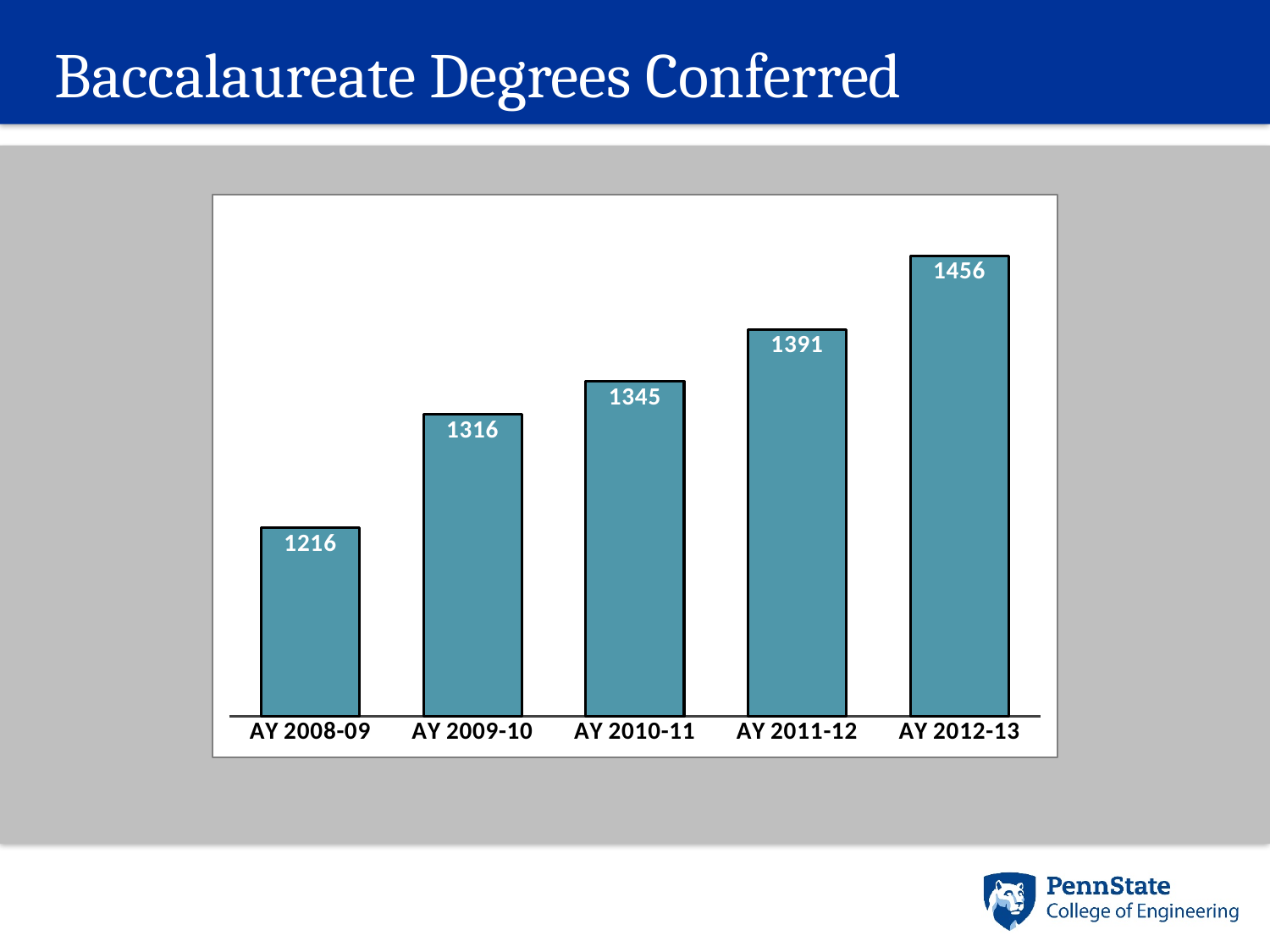
What is the title of the slide? Baccalaureate Degrees Conferred How many baccalaureate degrees were conferred in AY 2010-11? 1345 How many baccalaureate degrees were conferred in AY 2012-13? 1456 Do the number of degrees conferred rise or fall from AY 2008-09 to AY 2012-13? Rise What is the difference in degrees conferred between AY 2011-12 and AY 2010-11? 46 How many academic years are shown on the chart? 5 How many baccalaureate degrees were conferred in AY 2008-09? 1216 What is the difference in degrees conferred between AY 2012-13 and AY 2008-09? 240 Which year had more degrees conferred, AY 2009-10 or AY 2011-12? AY 2011-12 Which academic year had the lowest number of baccalaureate degrees conferred? AY 2008-09 What kind of chart is shown on the slide? Bar chart Which academic year had the highest number of baccalaureate degrees conferred? AY 2012-13